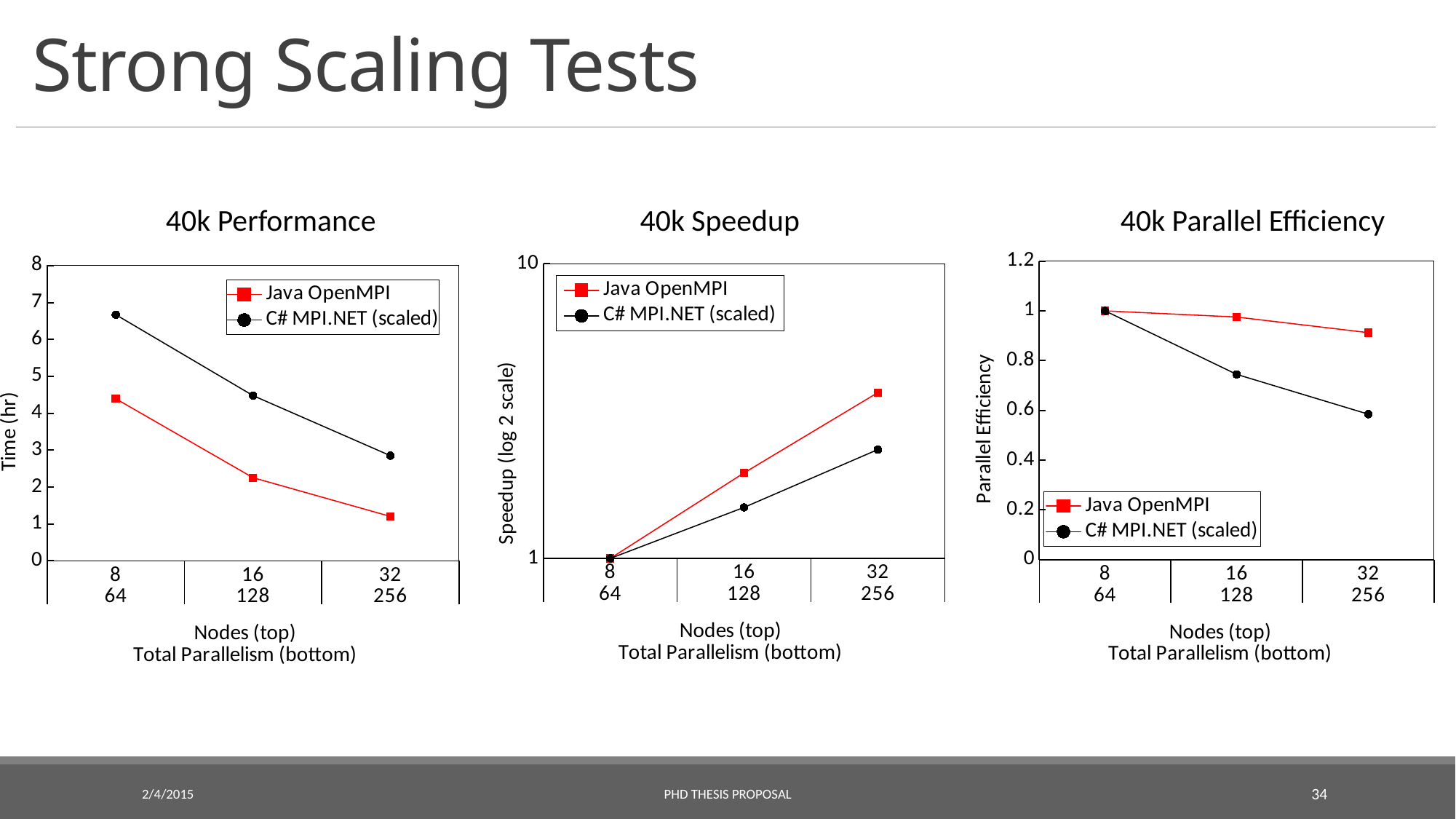
In the 40k Speedup chart, which series has the higher speedup at 32 nodes? Java OpenMPI In the 40k Parallel Efficiency chart, how many node counts are plotted along the x axis? 3 In the 40k Performance chart, which series has the higher time at 16 nodes? C# MPI.NET (scaled) In the 40k Performance chart, does the Java OpenMPI time rise or fall as the number of nodes increases? fall In the 40k Performance chart, is the time for Java OpenMPI at 32 nodes greater or less than 2? less In the 40k Speedup chart, does the Java OpenMPI speedup rise or fall as the number of nodes increases? rise In the 40k Speedup chart, how many series does the legend list? 2 What kind of chart is the 40k Performance chart? line chart What is the y-axis label of the 40k Speedup chart? Speedup (log 2 scale) In the 40k Parallel Efficiency chart, is the value for C# MPI.NET (scaled) at 32 nodes greater or less than 0.8? less In the 40k Performance chart, is the time for C# MPI.NET (scaled) at 8 nodes greater or less than 6? greater In the 40k Performance chart, at which node count is the time for C# MPI.NET (scaled) highest? 8